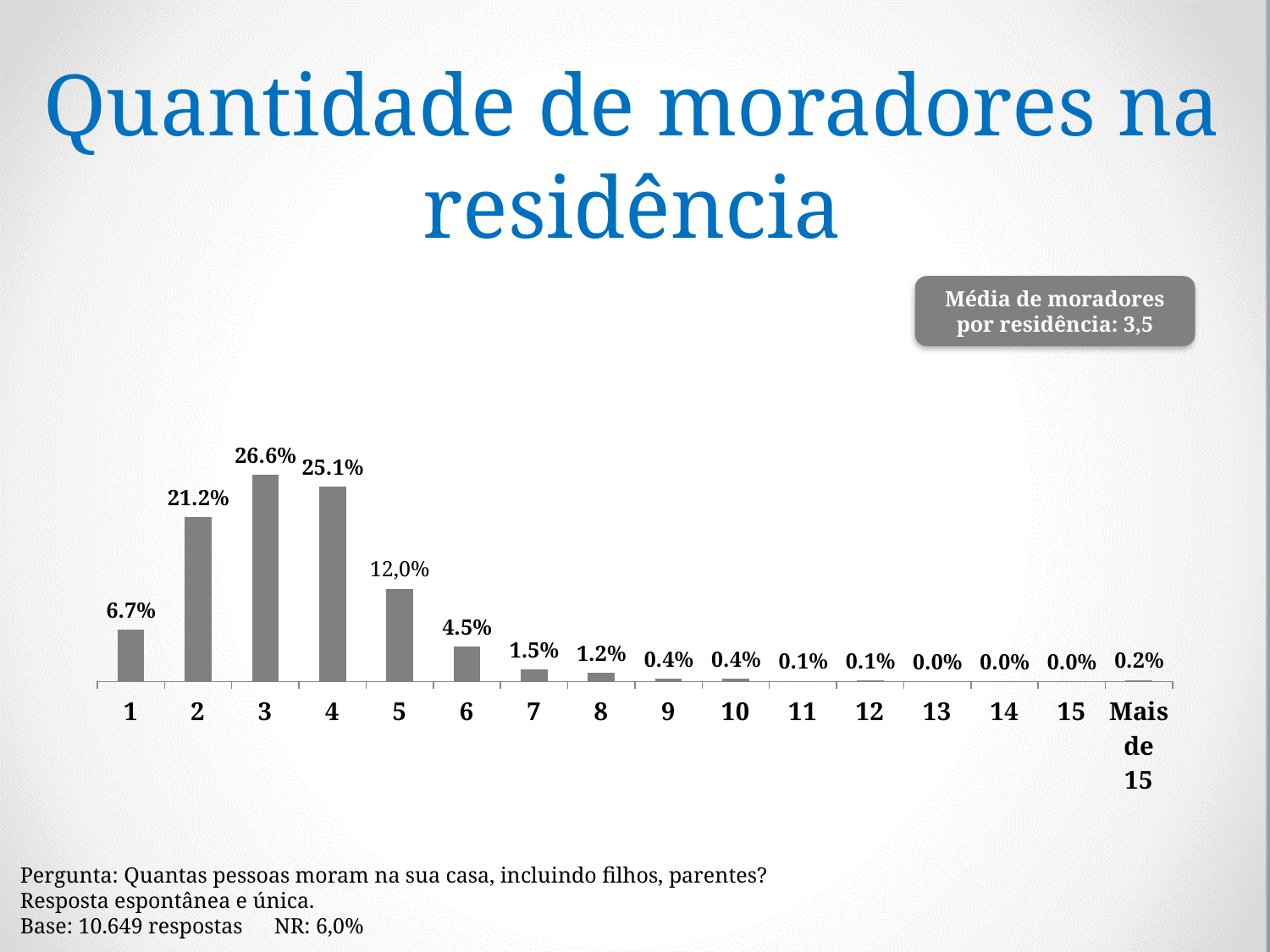
What is the difference between the values for 2 residents and 1 resident? 14.5% What percentage of residences have 3 residents? 26.6% What is the difference between the values for 3 residents and 4 residents? 1.5% What percentage is shown for the 'Mais de 15' category? 0.2% Which is larger, the value for 2 residents or the value for 4 residents? 4 residents What is the average number of residents per residence stated on the slide? 3,5 Which number of residents has the highest percentage? 3 What is the value for 1 resident? 6.7% What kind of chart is shown on the slide? Bar chart How many categories are shown on the x axis? 16 What is the value shown for 5 residents? 12,0% From 3 residents onward, do the values rise or fall as the number of residents increases? Fall